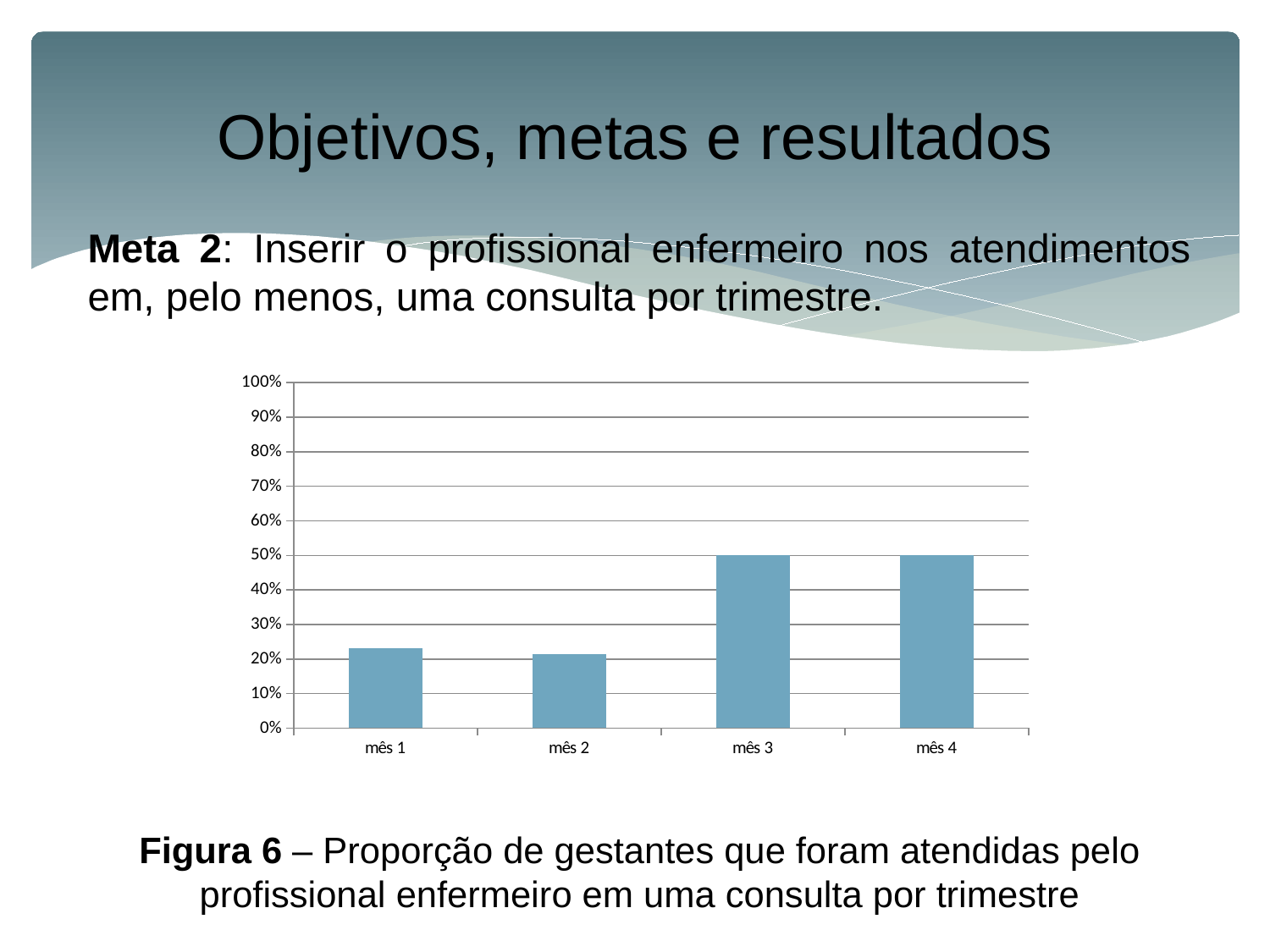
Is the value for mês 1 greater or less than 30%? less What is the value for mês 3 in the chart? 50% What is the highest value shown on the y axis of the chart? 100% Is the value for mês 2 greater or less than 30%? less Is the value for mês 4 greater or less than 60%? less What kind of chart is shown on the slide? bar chart Which is larger, the value for mês 1 or the value for mês 3? mês 3 What is the value for mês 4 in the chart? 50% Does the value rise or fall from mês 2 to mês 3? rise Which is larger, the value for mês 2 or the value for mês 4? mês 4 How many categories (months) are shown on the x axis of the chart? 4